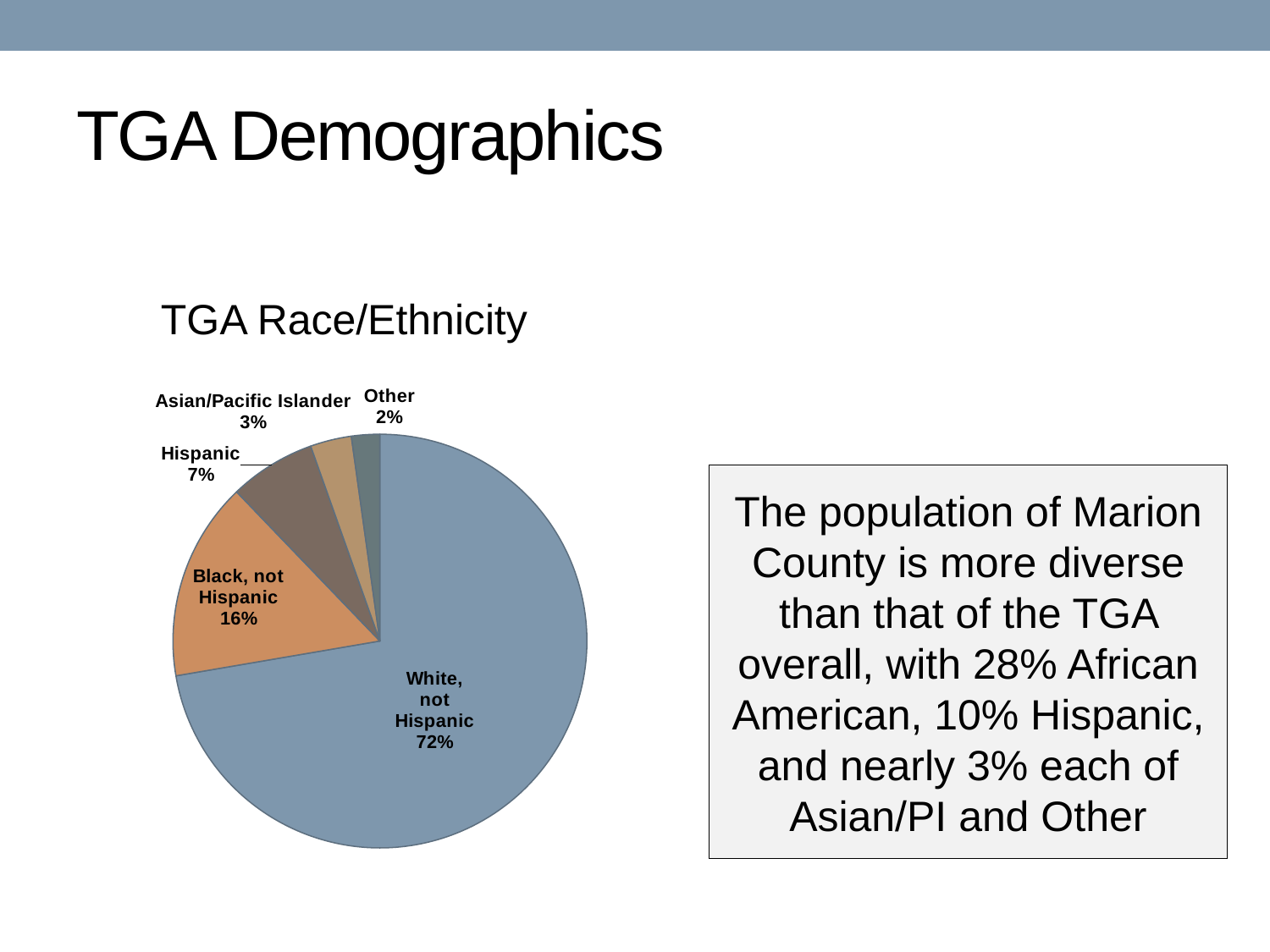
What is the title of the chart? TGA Race/Ethnicity What percentage is shown for Asian/Pacific Islander? 3% How many categories are shown in the pie chart? 5 What percentage is shown for Black, not Hispanic? 16% Which is larger, the Hispanic slice or the Asian/Pacific Islander slice? Hispanic What is the difference in percentage points between White, not Hispanic and Black, not Hispanic? 56 What percentage is shown for Hispanic? 7% Which category has the smallest slice of the pie? Other Which category has the largest slice of the pie? White, not Hispanic What percentage is shown for Other? 2% What kind of chart is shown on the slide? Pie chart What share of the pie is White, not Hispanic? 72%